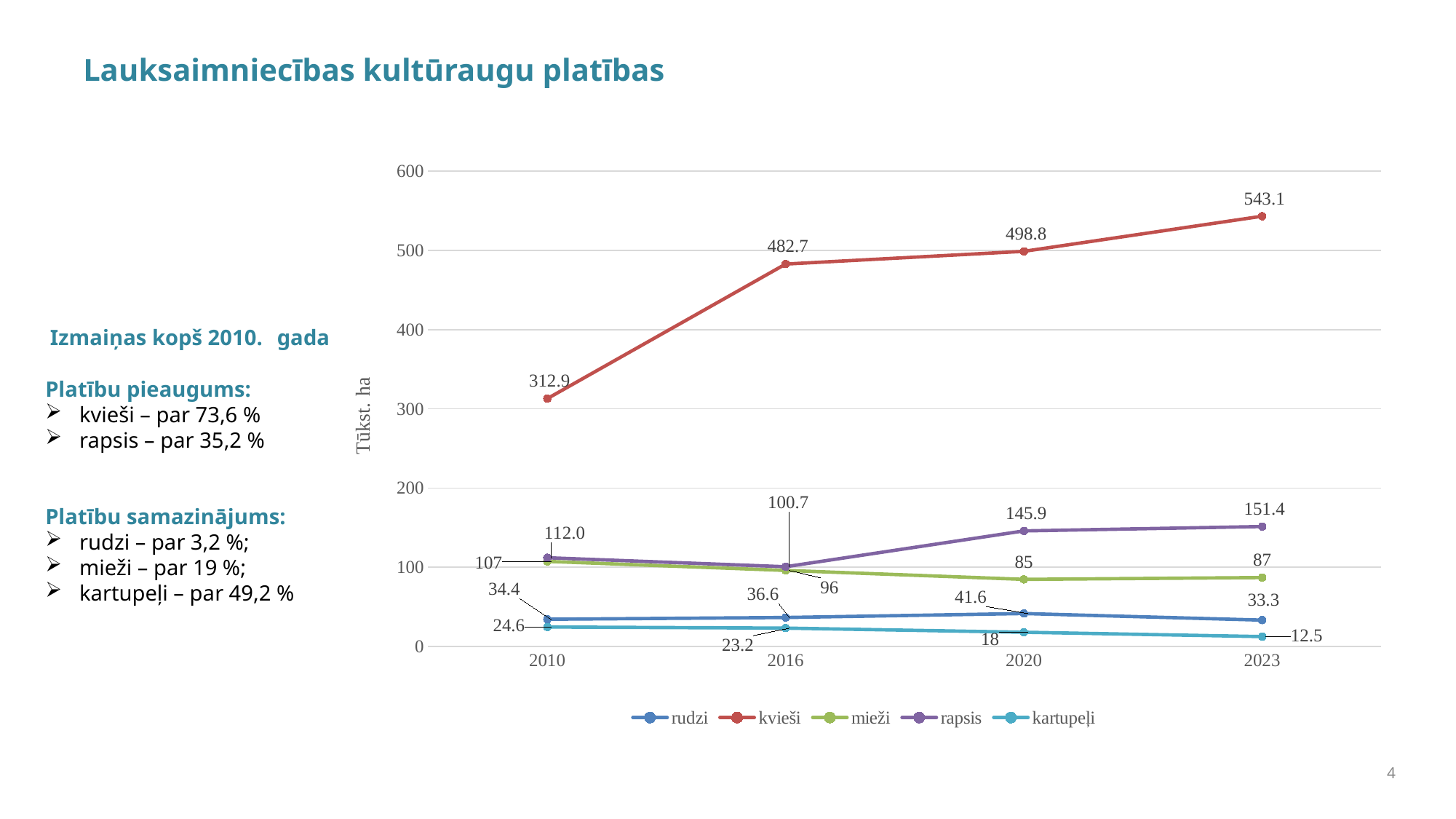
What is the difference between the kvieši values in 2023 and 2010? 230.2 What is the value for kvieši in 2023? 543.1 Which is larger in 2016: the value for rapsis or the value for mieži? rapsis Which series has the lowest value in 2023? kartupeļi What is the value for rapsis in 2020? 145.9 What is the value for kartupeļi in 2010? 24.6 What is the label of the vertical axis? Tūkst. ha How many years are shown on the x axis? 4 Do the values for kartupeļi rise or fall from 2010 to 2023? fall How many series does the legend list? 5 What kind of chart is shown on the slide? line chart Which series has the highest value in 2023? kvieši